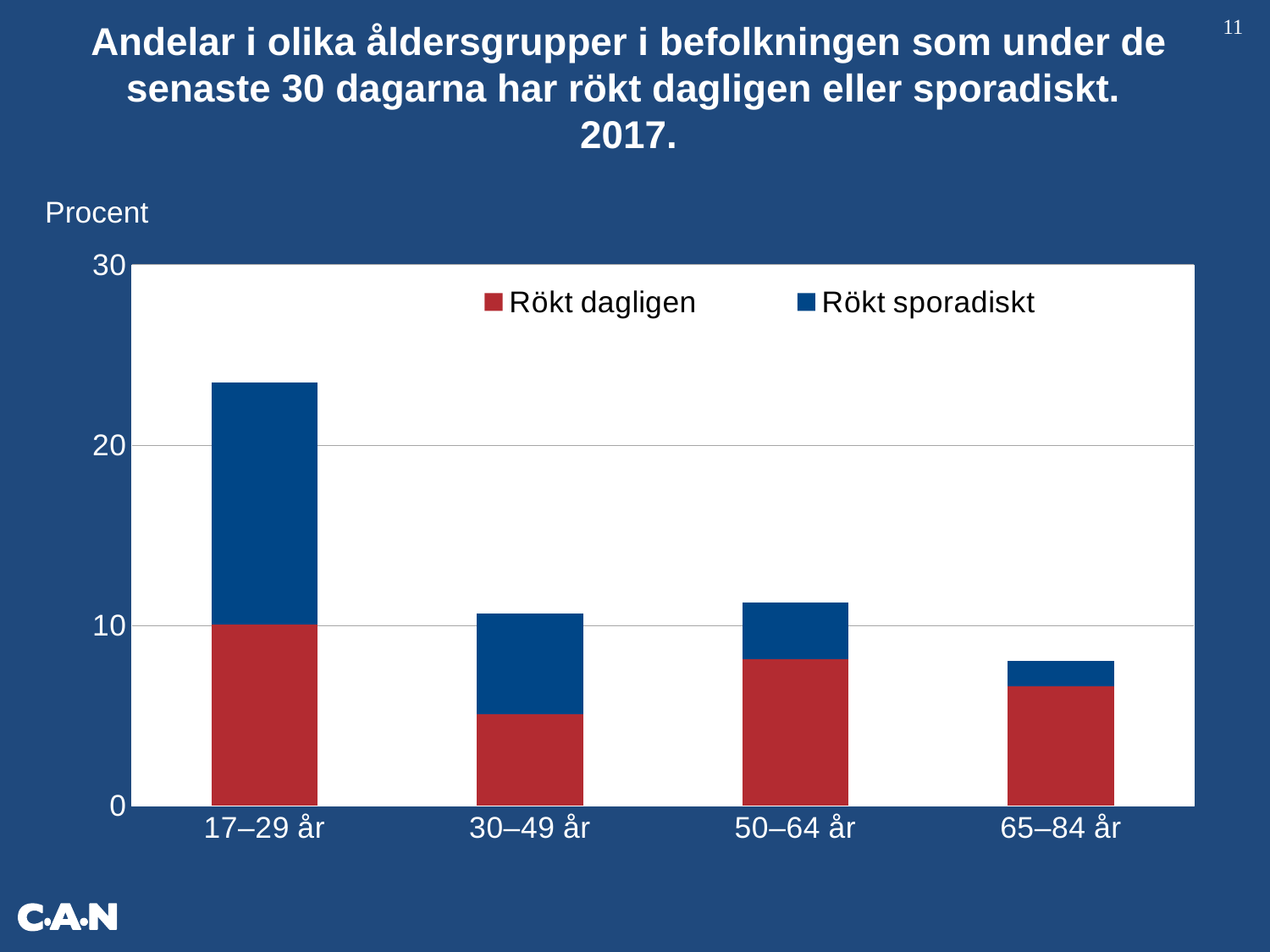
What label is shown above the y axis? Procent Which age group has the highest total bar? 17–29 år Which is larger, the 'Rökt dagligen' segment for 50–64 år or for 30–49 år? 50–64 år Is the total bar for 65–84 år greater or less than 10? less How many age groups are shown on the x axis? 4 Which age group has the lowest total bar? 65–84 år What kind of chart is shown on the slide? Stacked bar chart Which series is shown in red in the legend? Rökt dagligen How many series does the legend list? 2 Is the 'Rökt dagligen' value for 30–49 år greater or less than 10? less Which age group has the smallest 'Rökt dagligen' segment? 30–49 år Is the total bar for 17–29 år greater or less than 20? greater